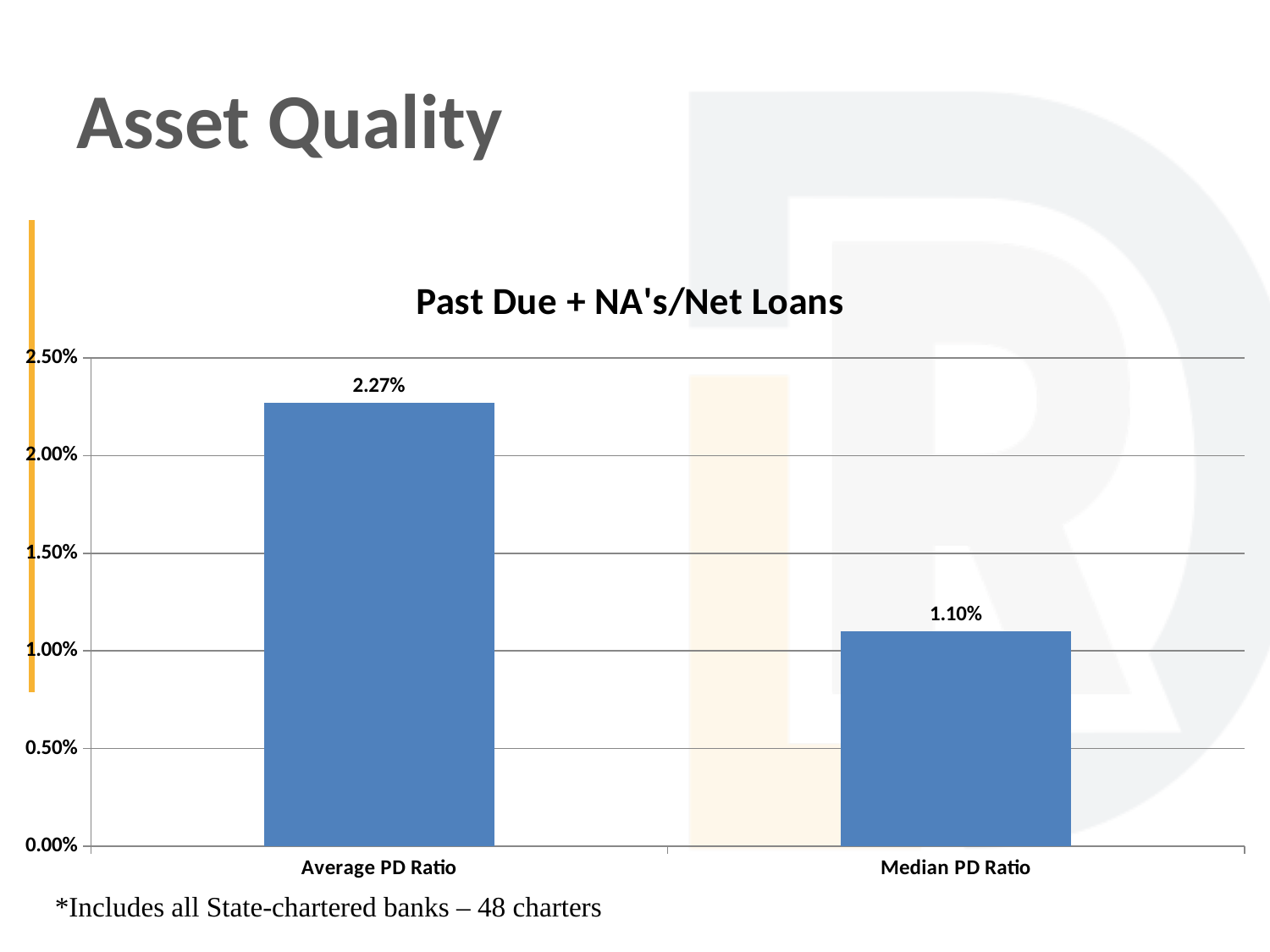
How many categories are shown in the chart? 2 Is the value for Median PD Ratio greater or less than 1.50%? less Which is larger, the Average PD Ratio or the Median PD Ratio? Average PD Ratio Which category has the lowest value? Median PD Ratio What is the difference between the Average PD Ratio and the Median PD Ratio? 1.17% Which category has the highest value? Average PD Ratio What is the value for Average PD Ratio? 2.27% What is the value for Median PD Ratio? 1.10% What kind of chart is shown on the slide? Bar chart What is the title of the chart? Past Due + NA's/Net Loans Is the value for Average PD Ratio greater or less than 2.00%? greater What is the highest value shown on the vertical axis? 2.50%